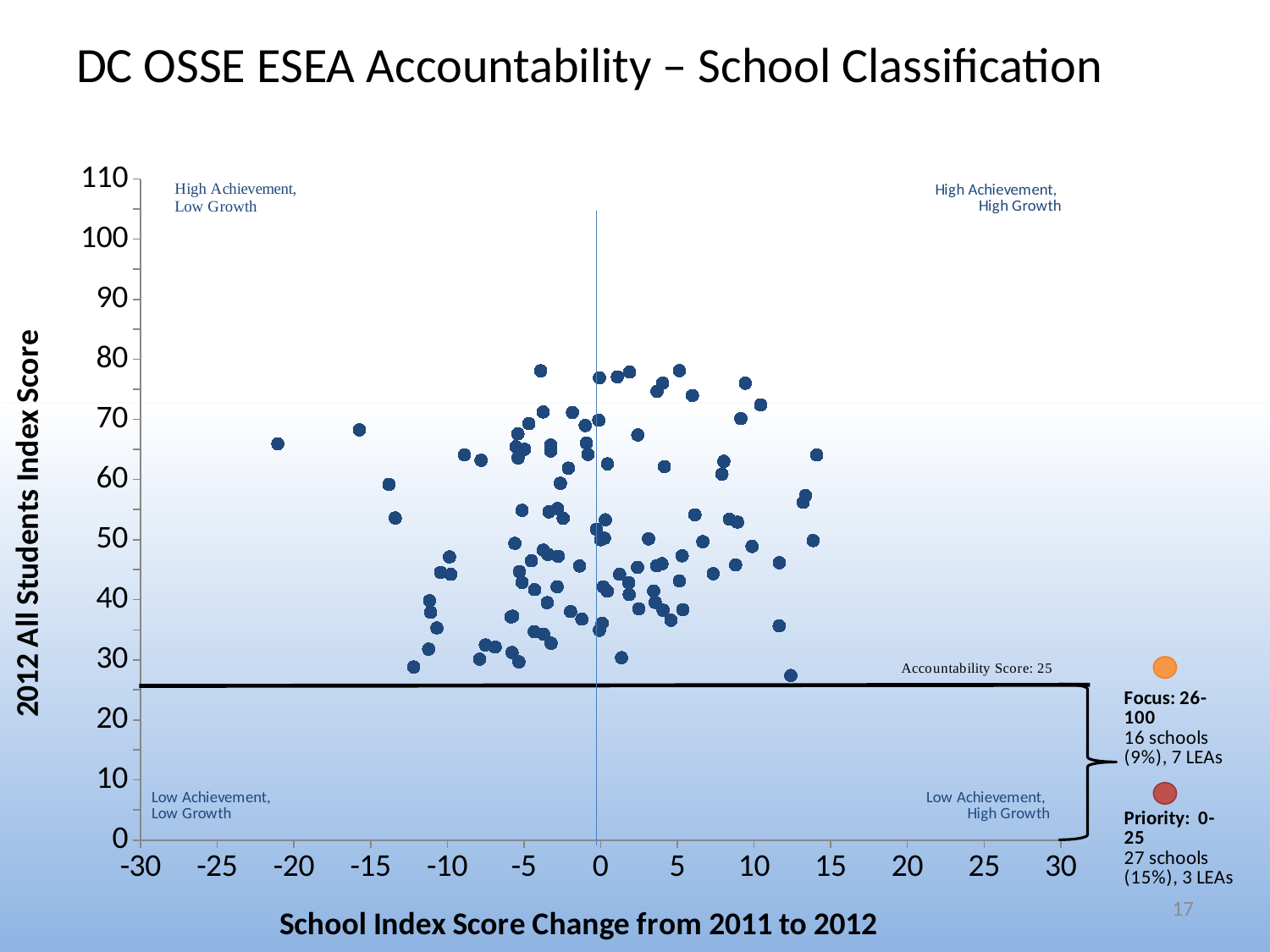
Is the x value of the rightmost point on the chart greater or less than 10? greater Is the y value of the highest point on the chart greater or less than 80? less What score range defines the Priority category on the chart? 0-25 How many schools are in the Priority category according to the chart annotation? 27 schools (15%) How many LEAs are listed for the Focus category on the chart? 7 LEAs How many schools are in the Focus category according to the chart annotation? 16 schools (9%) What kind of chart is shown on the slide? scatter chart What is the title of the x axis of the chart? School Index Score Change from 2011 to 2012 Is the y value of the leftmost point on the chart greater or less than 60? greater What Accountability Score does the horizontal line on the chart mark? 25 What is the title of the y axis of the chart? 2012 All Students Index Score